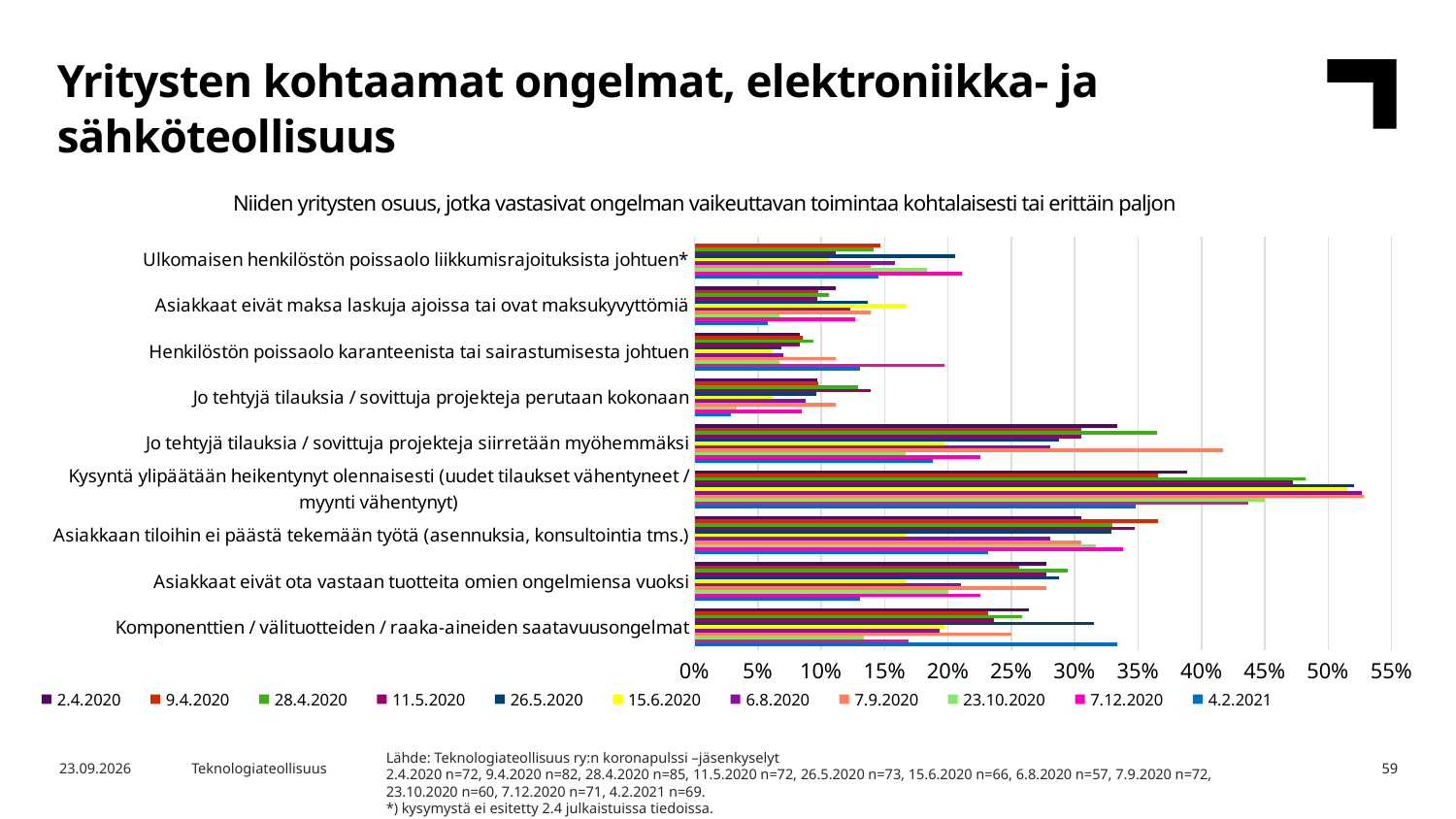
How many survey dates (series) does the legend list? 11 Is the 4.2.2021 value for 'Jo tehtyjä tilauksia / sovittuja projekteja perutaan kokonaan' greater or less than 5%? less Is the 4.2.2021 value for 'Komponenttien / välituotteiden / raaka-aineiden saatavuusongelmat' greater or less than 30%? greater For 'Komponenttien / välituotteiden / raaka-aineiden saatavuusongelmat', which is larger: the 4.2.2021 value or the 2.4.2020 value? 4.2.2021 What is the subtitle printed above the chart? Niiden yritysten osuus, jotka vastasivat ongelman vaikeuttavan toimintaa kohtalaisesti tai erittäin paljon Which problem category has the longest bars overall on the chart? Kysyntä ylipäätään heikentynyt olennaisesti (uudet tilaukset vähentyneet / myynti vähentynyt) What is the highest value shown on the horizontal axis? 55% For 'Kysyntä ylipäätään heikentynyt olennaisesti', which is larger: the 9.4.2020 value or the 4.2.2021 value? 9.4.2020 Is the 7.9.2020 value for 'Jo tehtyjä tilauksia / sovittuja projekteja siirretään myöhemmäksi' greater or less than 35%? greater How many problem categories are listed on the chart's vertical axis? 9 What kind of chart is shown on the slide? Bar chart